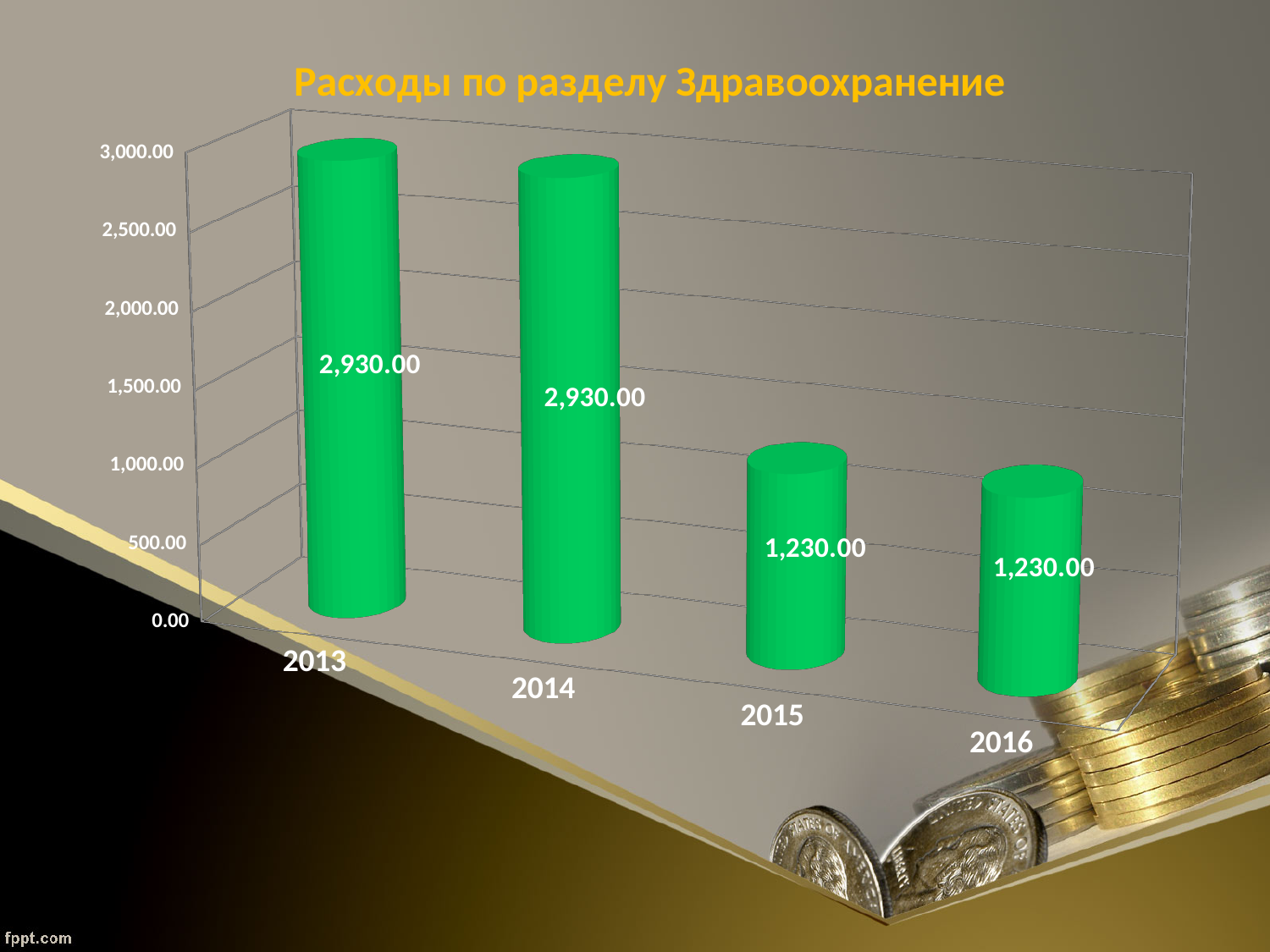
What is the value for 2015? 1,230.00 What is the value for 2014? 2,930.00 What is the difference between the values for 2014 and 2015? 1,700.00 How many years are shown on the x axis? 4 Which is larger, the value for 2013 or the value for 2016? 2013 Do the values rise or fall from 2013 to 2016? fall What is the value for 2016? 1,230.00 Is the value for 2015 greater or less than 1,500.00? less What kind of chart is this? bar chart What is the value for 2013? 2,930.00 What is the title of the chart? Расходы по разделу Здравоохранение Is the value for 2013 greater or less than 2,500.00? greater